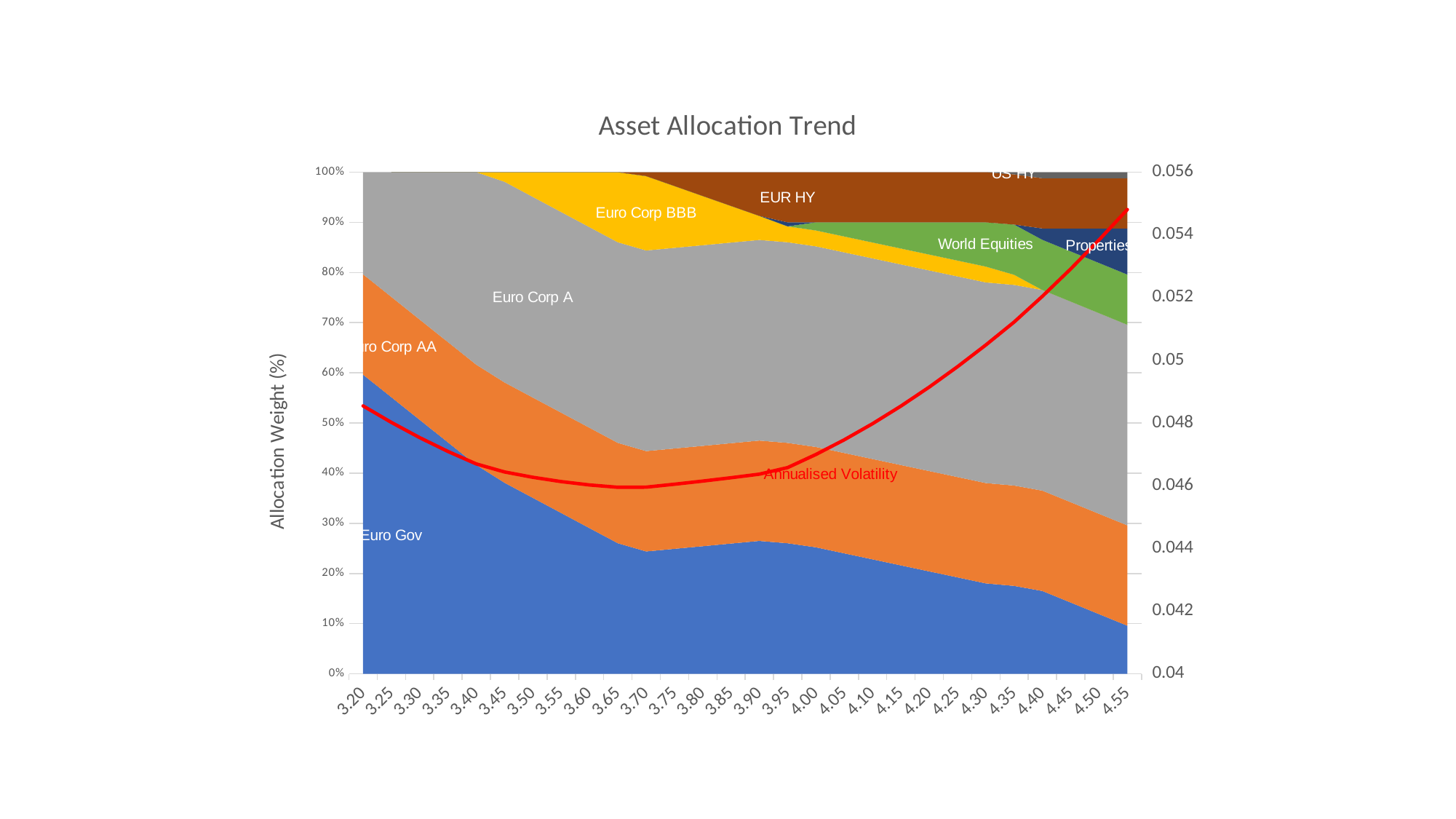
Is the Euro Gov allocation at 3.20 greater or less than 50%? greater Which asset class occupies the bottom area of the stacked chart? Euro Gov Is the Euro Gov allocation at 4.55 greater or less than 20%? less Does the Annualised Volatility line rise or fall between 4.00 and 4.55? Rise What is the title of the chart? Asset Allocation Trend Is the Annualised Volatility value at 3.70 greater or less than 0.048? less How many points are shown on the x axis from 3.20 to 4.55? 28 What is the maximum value shown on the right-hand vertical axis? 0.056 Does the Euro Gov allocation rise or fall as the x axis moves from 3.20 to 4.55? Fall What kind of chart is shown on the slide? Stacked area chart with a line What is the label of the left vertical axis? Allocation Weight (%)